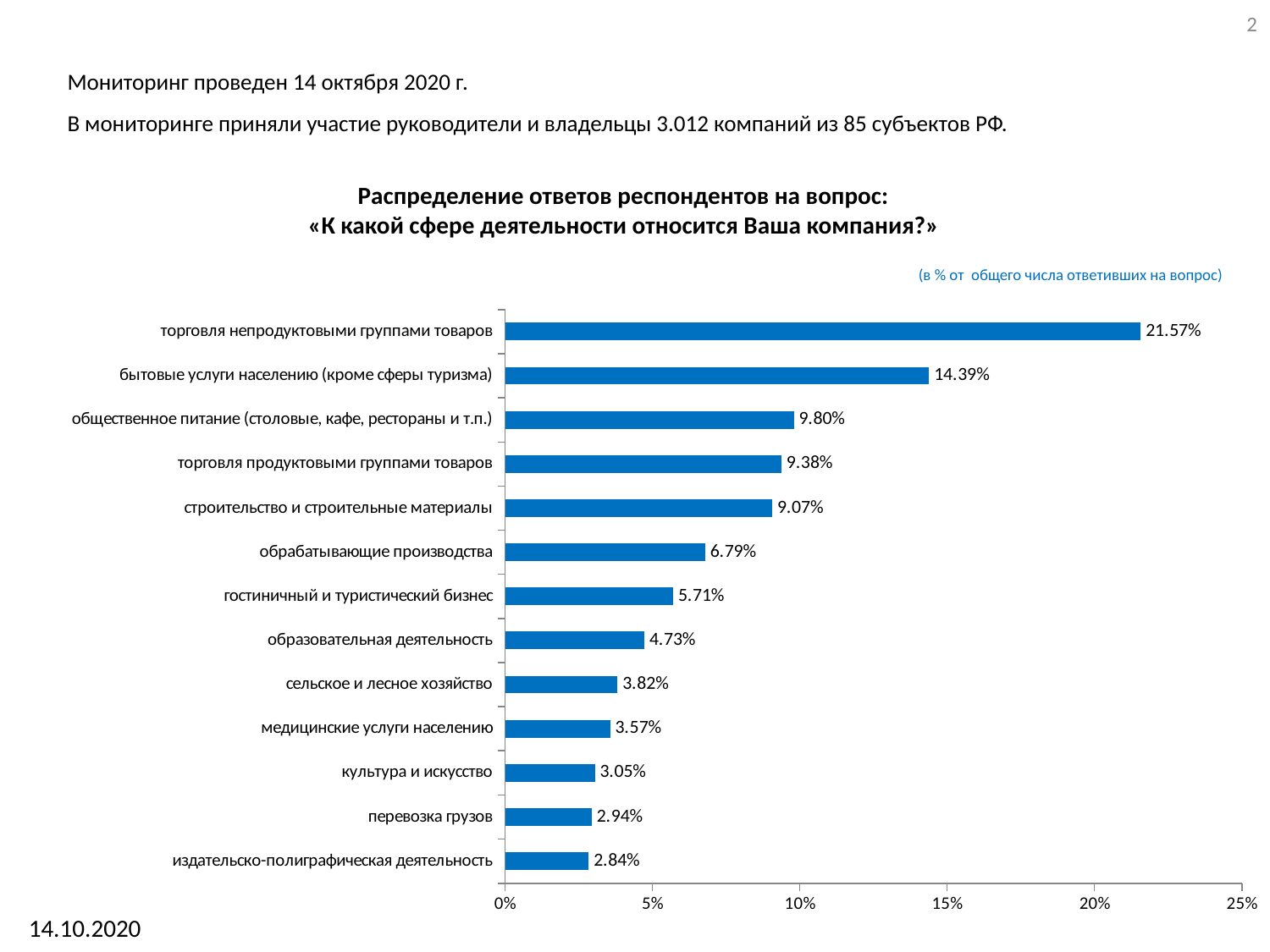
Which category has the highest value? торговля непродуктовыми группами товаров What is the value for «торговля непродуктовыми группами товаров»? 21.57% What is the difference between «обрабатывающие производства» and «гостиничный и туристический бизнес»? 1.08% Which category has the lowest value? издательско-полиграфическая деятельность Which is larger: «торговля продуктовыми группами товаров» or «строительство и строительные материалы»? торговля продуктовыми группами товаров What is the value for «медицинские услуги населению»? 3.57% Is the value for «бытовые услуги населению (кроме сферы туризма)» greater or less than 15%? less What kind of chart is shown on the slide? bar chart What is the value for «обрабатывающие производства»? 6.79% What is the title of the chart? Распределение ответов респондентов на вопрос: «К какой сфере деятельности относится Ваша компания?» What is the difference between «торговля непродуктовыми группами товаров» and «бытовые услуги населению (кроме сферы туризма)»? 7.18% How many categories are shown in the chart? 13